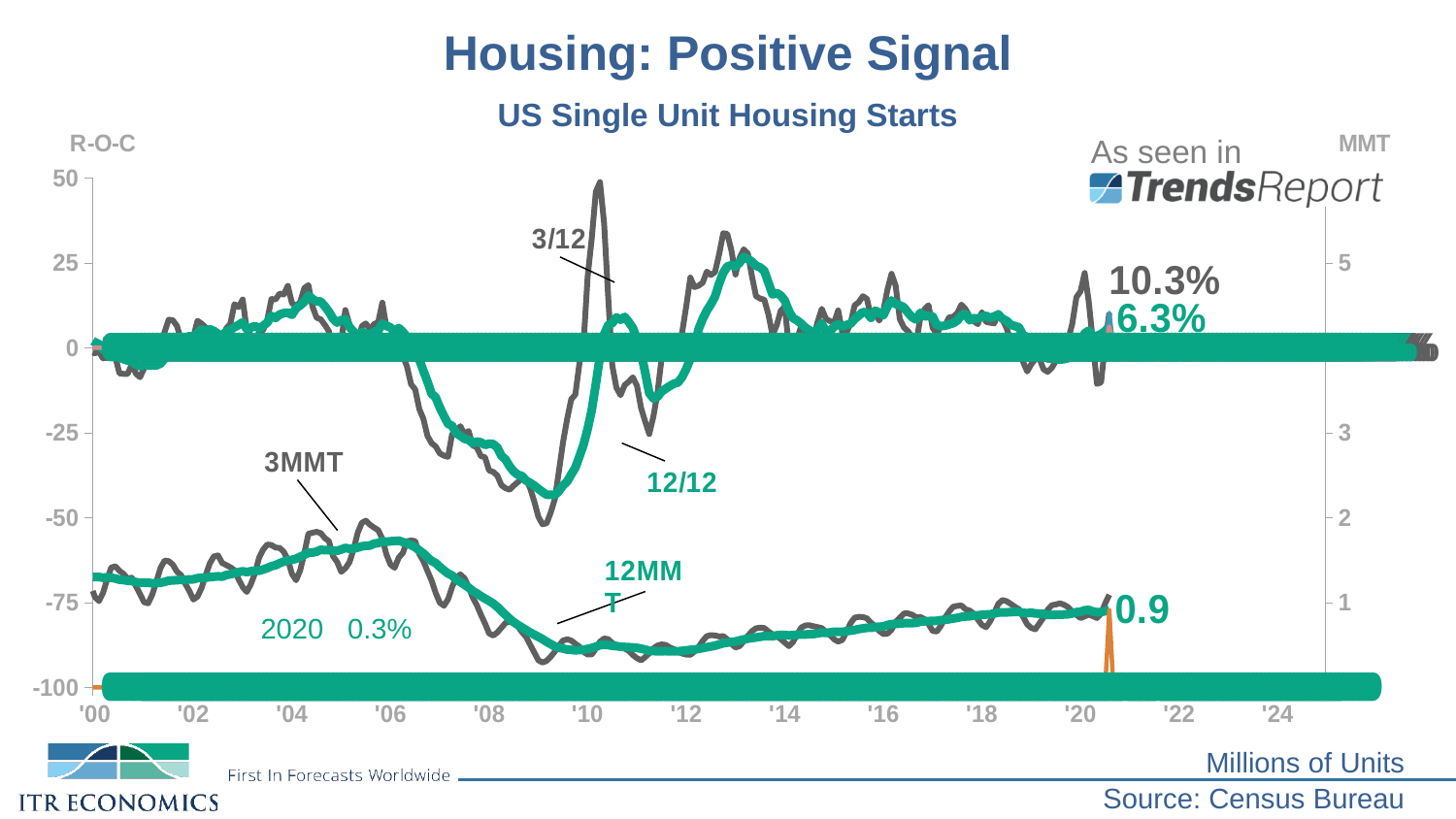
What is the latest value shown for the 3/12 rate-of-change line? 10.3% What is the latest value shown for the 12MMT line? 0.9 What source is cited for the chart data? Census Bureau What is the latest value shown for the 12/12 rate-of-change line? 6.3% Does the 12MMT line rise or fall between '10 and '20? rise Around 2009, is the lowest value of the 12/12 line greater or less than -25? less Which is larger at the latest data point, the 3/12 value or the 12/12 value? 3/12 What is the difference between the latest 3/12 value (10.3%) and the latest 12/12 value (6.3%)? 4.0% What percentage is shown next to the 2020 label on the chart? 0.3% How many labeled lines are plotted on the chart? 4 What kind of chart is shown on the slide? line chart What is the title of the chart? US Single Unit Housing Starts